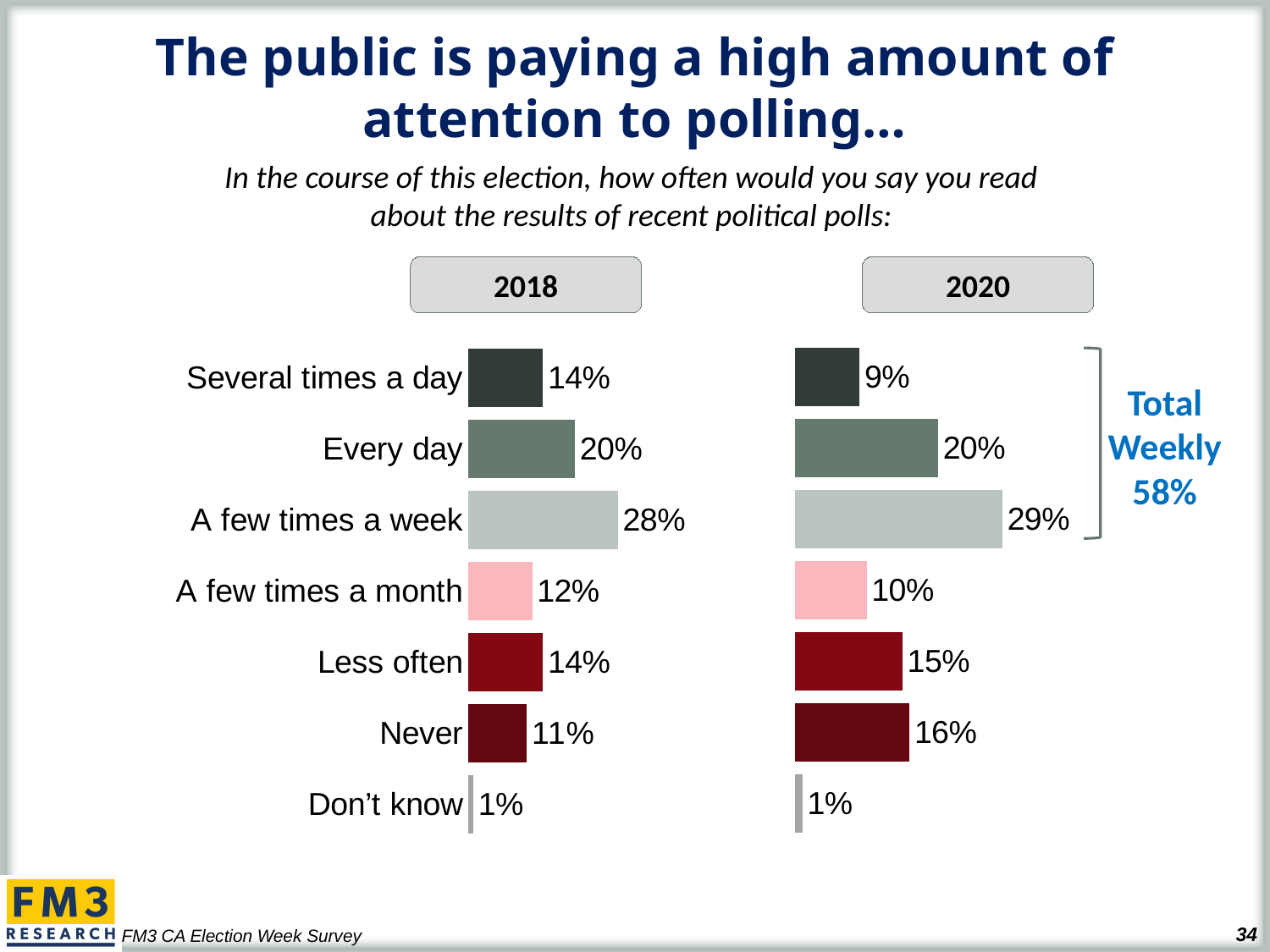
In the 2018 chart, which category has the highest percentage? A few times a week What type of chart is used on this slide? Bar chart How many categories are shown in each chart? 7 What is the total weekly percentage shown for 2020? 58% Is the 2020 value for 'Never' larger or smaller than the 2018 value for 'Never'? larger What is the difference between the 2018 and 2020 values for 'Several times a day'? 5 percentage points In the 2018 chart, what is the combined percentage for 'Several times a day', 'Every day' and 'A few times a week'? 62% In the 2020 chart, which category has the lowest percentage? Don't know In the 2020 chart, what percentage said 'Never'? 16% In the 2020 chart, what percentage said they read about poll results a few times a week? 29% Which two years are compared on the slide? 2018 and 2020 In the 2018 chart, what percentage said they read about poll results several times a day? 14%